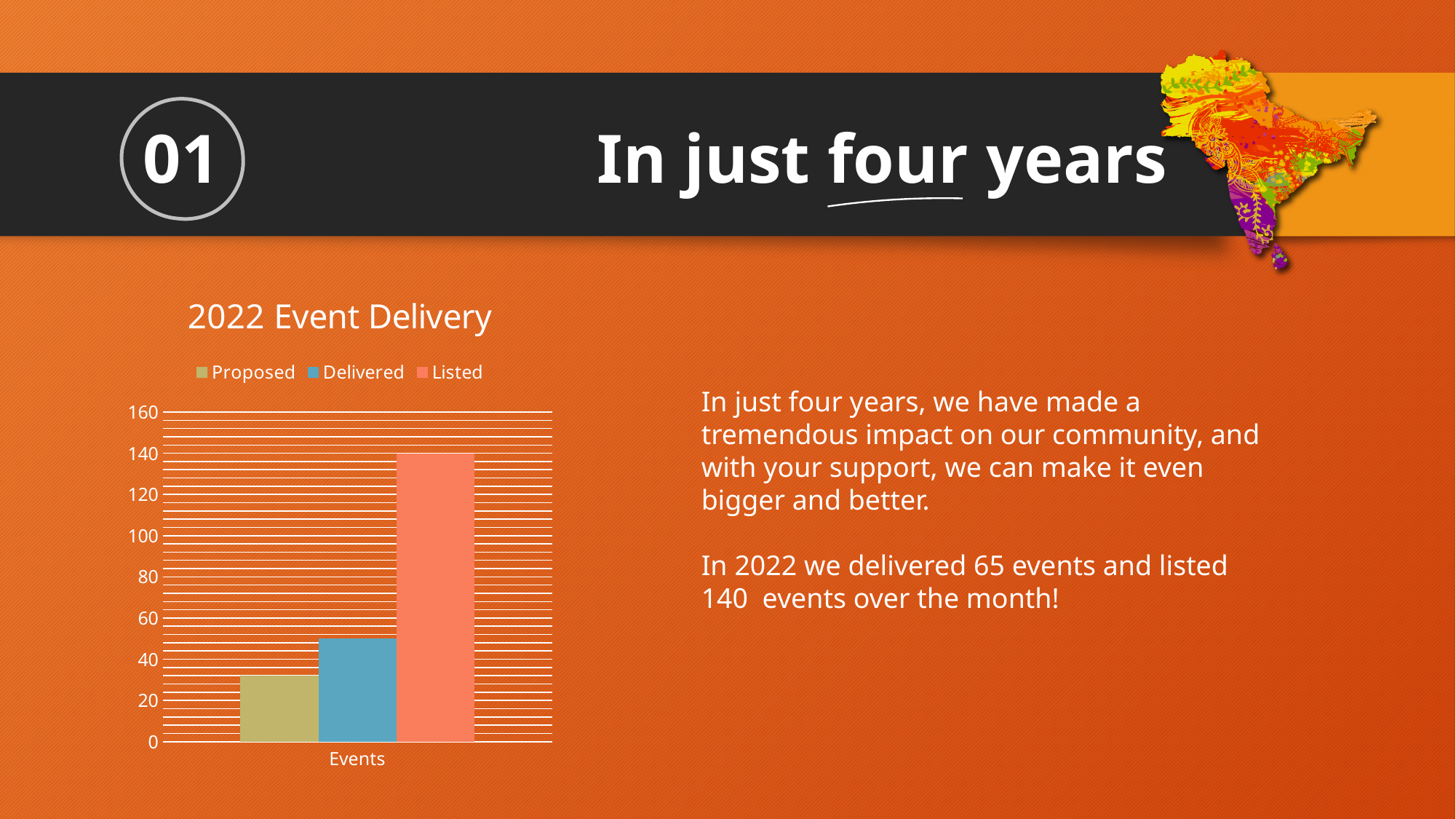
Which series is shown in blue in the chart? Delivered What is the title of the chart? 2022 Event Delivery Which is larger, the Delivered bar or the Proposed bar? Delivered Which series has the lowest value for Events? Proposed What is the value of the Listed bar for Events? 140 Is the value for Delivered greater or less than 40? greater Is the value for Delivered greater or less than 60? less Is the value for Proposed greater or less than 40? less What kind of chart is shown on the slide? bar chart Which series has the highest value for Events? Listed How many series does the chart legend list? 3 How many categories are shown on the x axis of the chart? 1